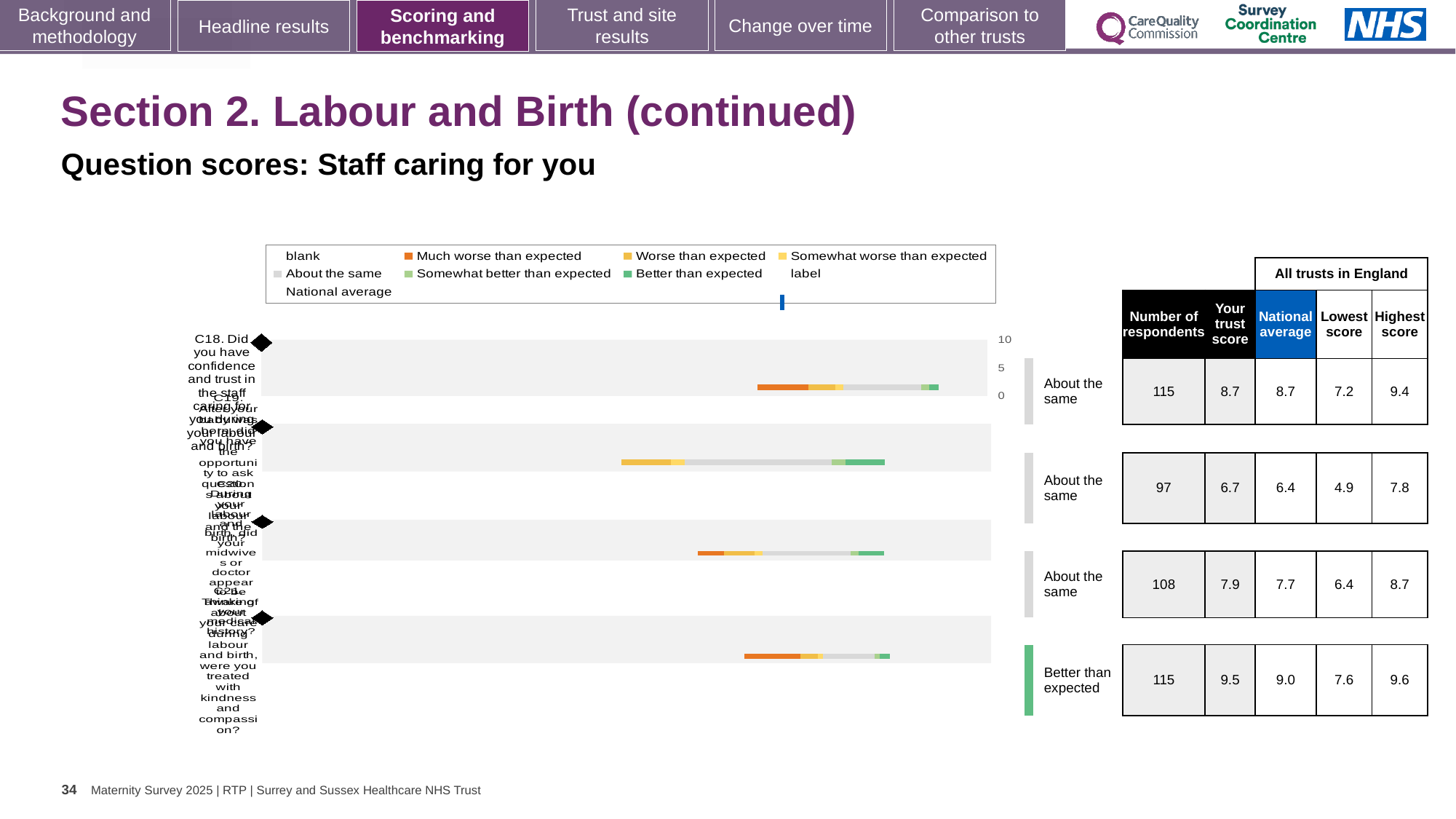
What kind of chart is shown on the slide? bar chart For the fourth row, what is the difference between 'Your trust score' and the national average? 0.5 What is the lowest score among all trusts in England for the second row? 4.9 What is the number of respondents for the second row of the table? 97 How many survey questions (rows) are plotted in the chart? 4 What is the highest score among all trusts in England for the third row? 8.7 Which row is rated 'Better than expected' rather than 'About the same'? the fourth row For the third row, which is larger: 'Your trust score' or the national average? Your trust score (7.9) What is the 'Your trust score' for the first row (C18, confidence and trust in the staff caring for you)? 8.7 Which row has the highest 'Your trust score'? the fourth row (9.5) Which row has the lowest 'Your trust score'? the second row (6.7) What is the national average for the first row of the table? 8.7